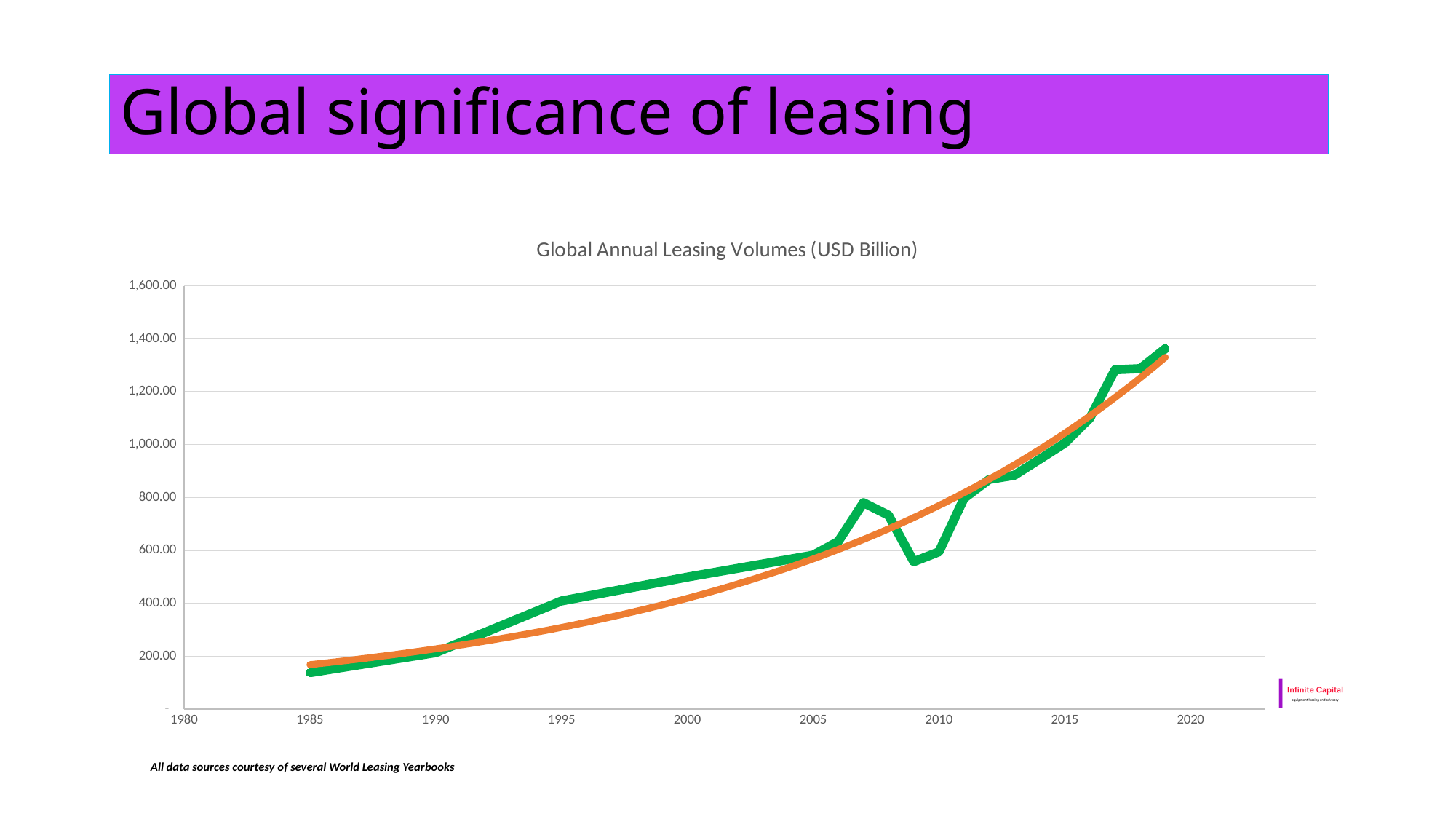
Overall, do the plotted leasing volumes rise or fall from 1985 to 2019? rise How many lines are plotted on the chart? 2 What is the title of the chart? Global Annual Leasing Volumes (USD Billion) Is the value of the green line in 2000 greater or less than 400? greater Which is larger, the green line's value in 2007 or its value in 2009? 2007 In which year does the green line reach its highest value? 2019 Is the value of the green line in 2019 greater or less than 1,200? greater What kind of chart is shown on the slide? line chart Is the value of the green line in 2009 greater or less than 600? less In which year does the green line have its lowest value? 1985